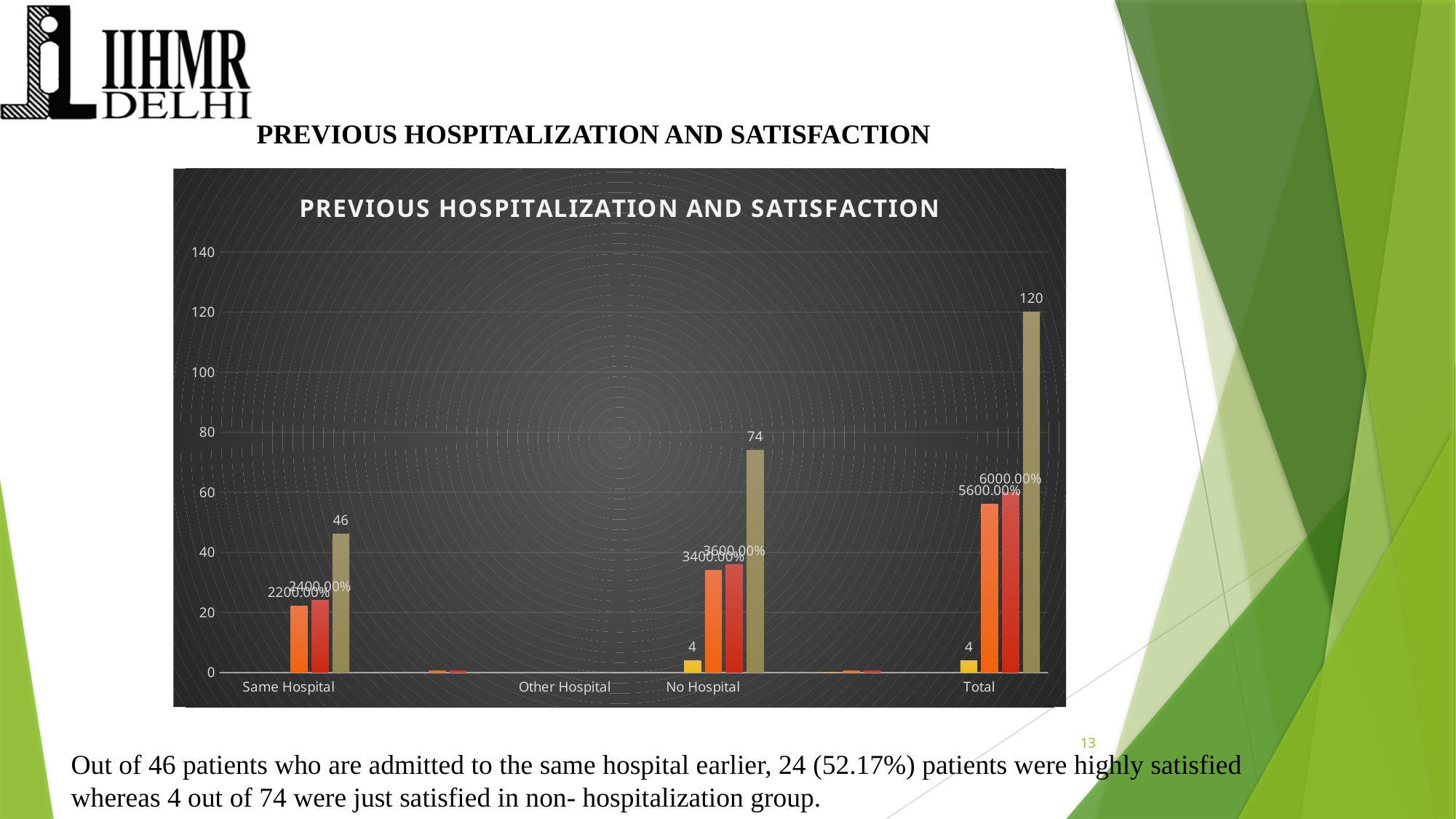
What kind of chart is shown on the slide? bar chart What is the value of the yellow (leftmost) bar for No Hospital? 4 Which category has the tallest tan (rightmost) bar? Total Is the tan bar for No Hospital greater or less than 60? greater What is the value of the tan (rightmost) bar for Total? 120 What is the data label on the orange bar for Total? 5600.00% What is the value of the tan (rightmost) bar for No Hospital? 74 Which category has the lowest bars overall? Other Hospital What is the value of the tan (rightmost) bar for Same Hospital? 46 What is the data label on the red bar for Same Hospital? 2400.00% What is the difference between the tan bar for Total and the tan bar for No Hospital? 46 How many categories are shown on the x axis of the chart? 4